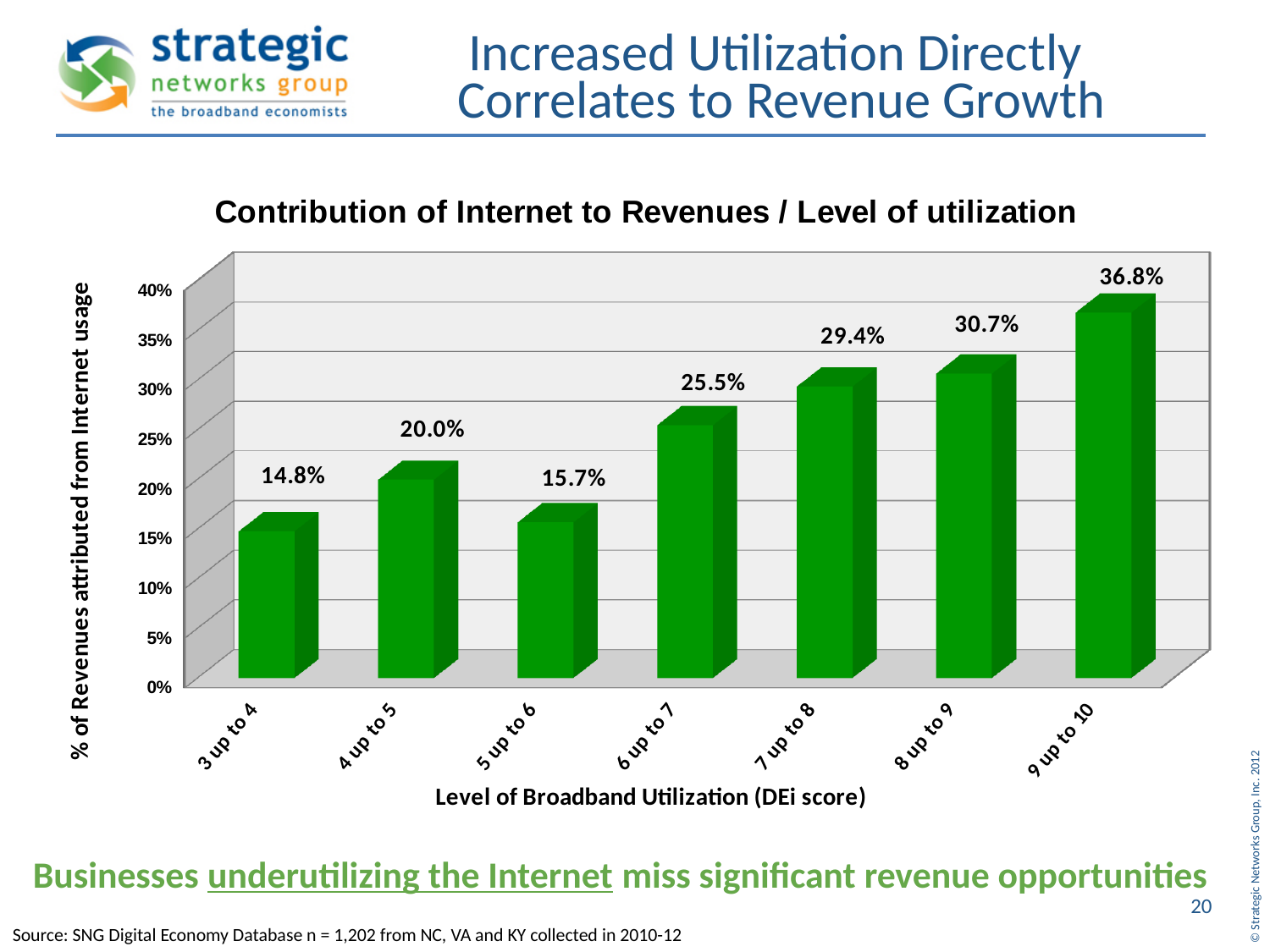
Which utilization level has the highest percentage of revenues attributed to Internet usage? 9 up to 10 What is the value for the "6 up to 7" utilization level? 25.5% What is the difference between the values for "7 up to 8" and "6 up to 7"? 3.9% Which is larger, the value for "4 up to 5" or the value for "5 up to 6"? 4 up to 5 What is the difference between the values for "9 up to 10" and "3 up to 4"? 22.0% Which utilization level has the lowest percentage of revenues attributed to Internet usage? 3 up to 4 What is the value for the "3 up to 4" utilization level? 14.8% What kind of chart is shown on the slide? Bar chart What is the label of the x axis? Level of Broadband Utilization (DEi score) How many utilization level categories are shown on the chart? 7 What is the title of the chart? Contribution of Internet to Revenues / Level of utilization What is the value for the "8 up to 9" utilization level? 30.7%